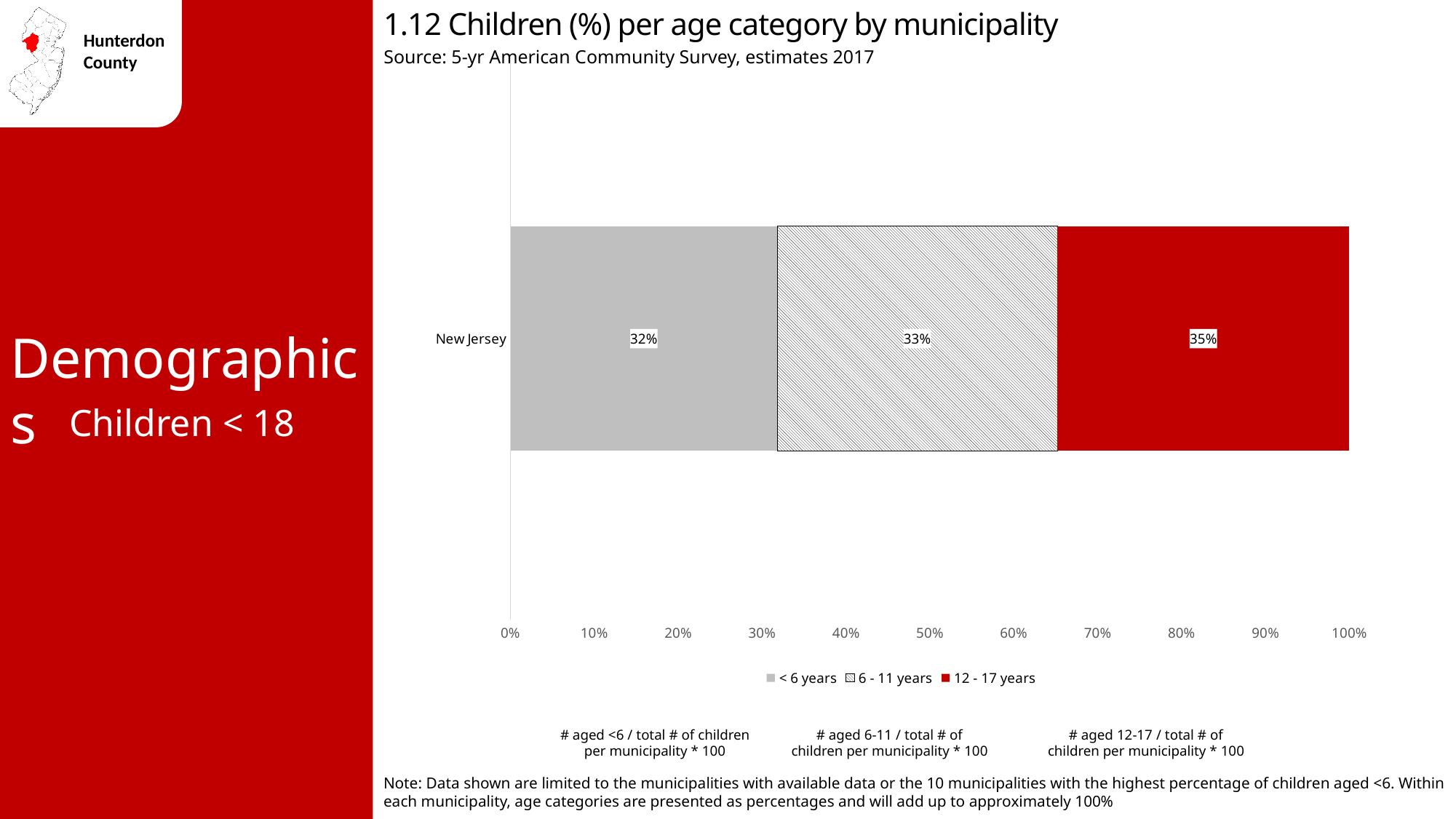
How many municipalities (categories) are shown on the chart? 1 What type of chart is shown on the slide? Stacked bar chart What percentage of children in New Jersey are aged 12 - 17 years? 35% What is the difference between the 12 - 17 years share and the < 6 years share for New Jersey? 3% What is the total of the three segments in the New Jersey bar? 100% Which age category is shown in red on the chart? 12 - 17 years Which age category has the smallest share of children in New Jersey? < 6 years Which is larger for New Jersey: the 6 - 11 years share or the 12 - 17 years share? 12 - 17 years Which age category has the largest share of children in New Jersey? 12 - 17 years What percentage of children in New Jersey are aged under 6 years? 32% What percentage of children in New Jersey are aged 6 - 11 years? 33% How many series does the legend list? 3